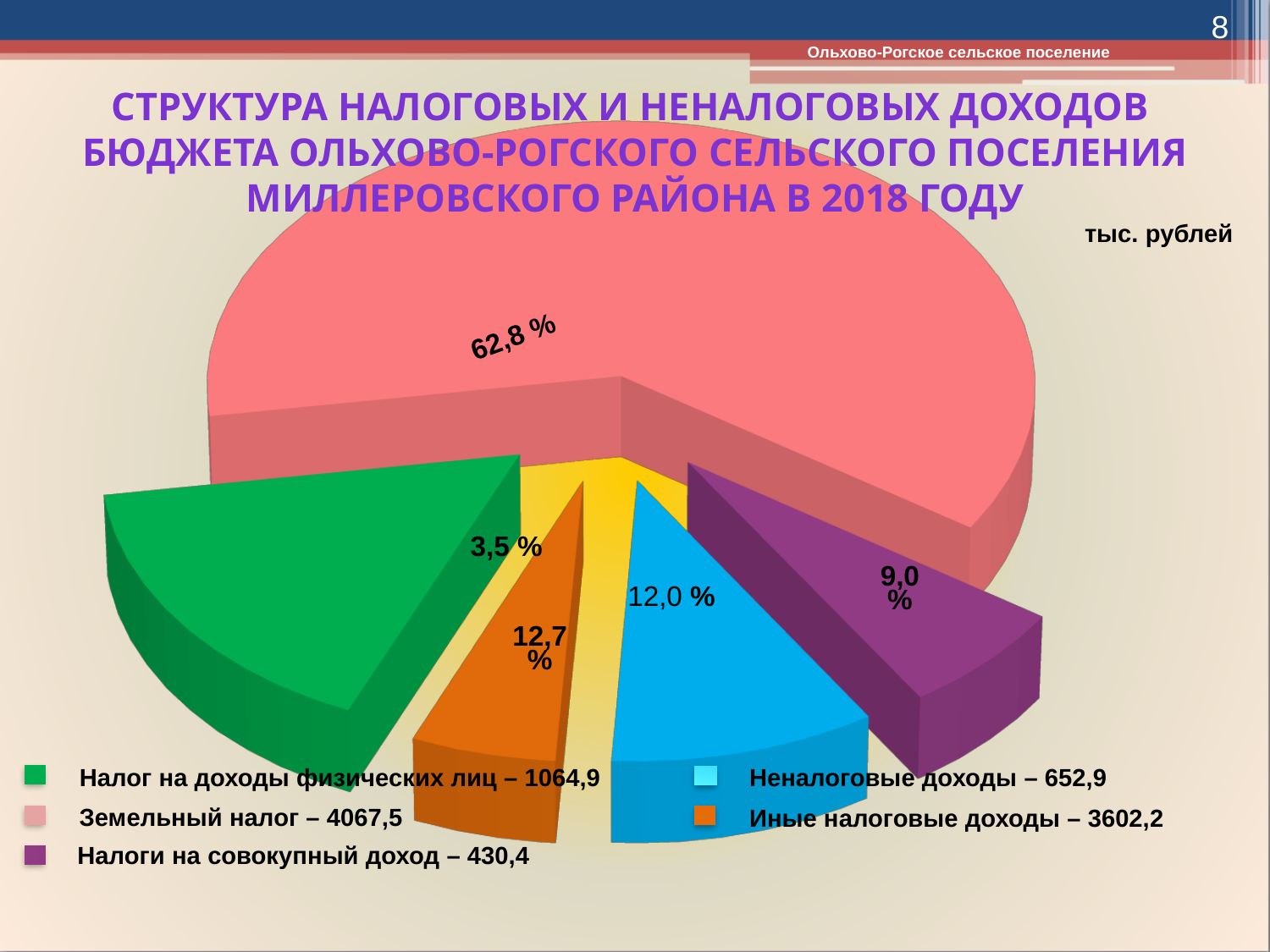
What percentage share is labelled on the largest (pink) slice, Земельный налог? 62,8 % How many categories (slices) does the pie chart have? 5 What value is given in the legend for Налог на доходы физических лиц? 1064,9 Which category has the largest value? Земельный налог What value is given in the legend for Неналоговые доходы? 652,9 What value is given in the legend for Иные налоговые доходы? 3602,2 Which is larger according to the legend: Земельный налог or Иные налоговые доходы? Земельный налог Which category has the smallest value according to the legend? Налоги на совокупный доход What value is given in the legend for Земельный налог? 4067,5 What kind of chart is shown on the slide? pie chart What value is given in the legend for Налоги на совокупный доход? 430,4 What is the difference between the legend values for Земельный налог and Налог на доходы физических лиц? 3002,6